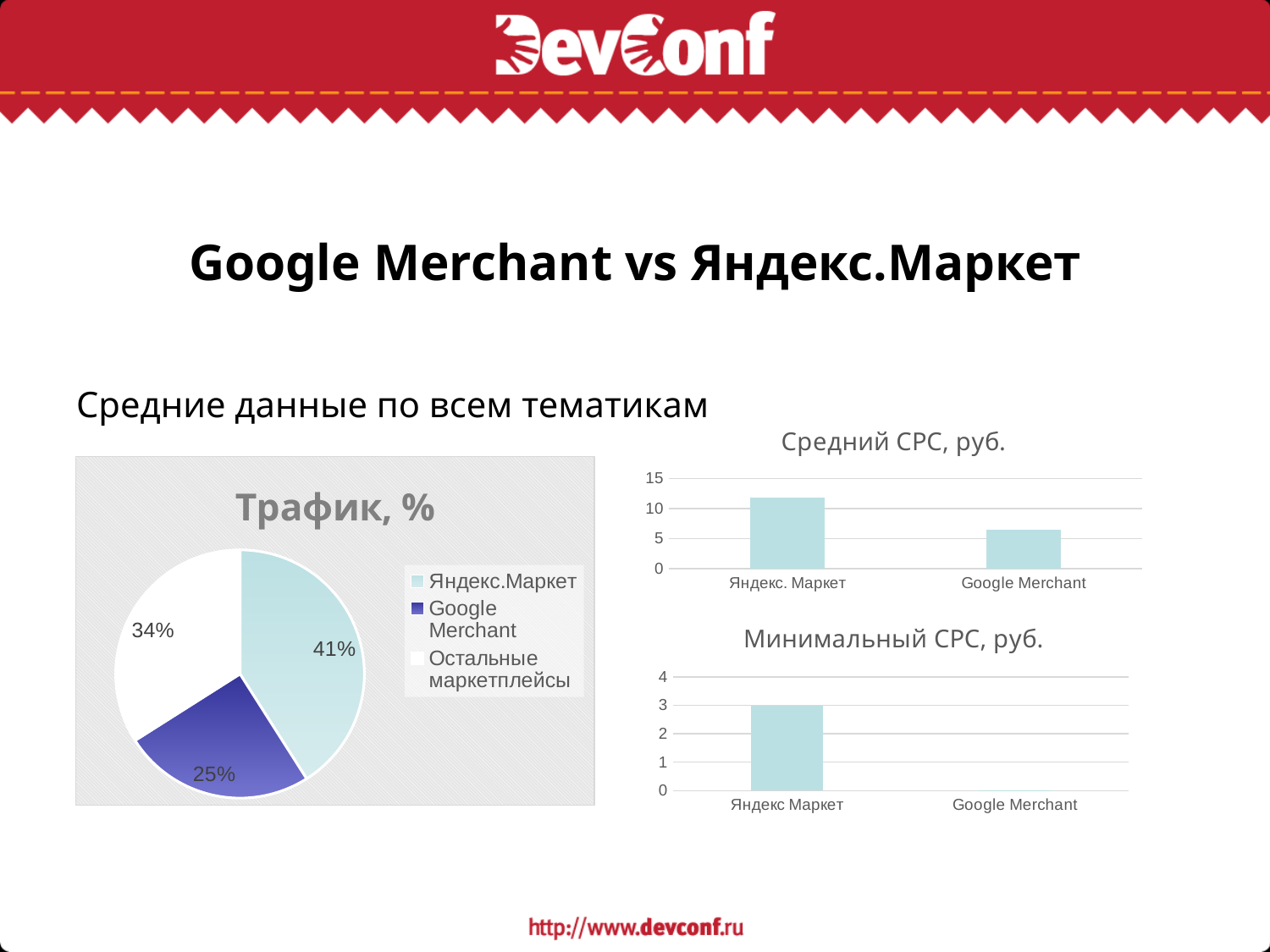
In the pie chart 'Трафик, %', what share do Остальные маркетплейсы have? 34% In the chart 'Средний CPC, руб.', is the value for Яндекс. Маркет greater or less than 10? greater In the chart 'Минимальный CPC, руб.', is the value for Google Merchant greater or less than 1? less In the chart 'Средний CPC, руб.', which category has the higher value, Яндекс. Маркет or Google Merchant? Яндекс. Маркет In the pie chart 'Трафик, %', what share does Яндекс.Маркет have? 41% What kind of chart is 'Средний CPC, руб.'? bar chart In the pie chart 'Трафик, %', what is the difference between the shares of Яндекс.Маркет and Google Merchant? 16% How many categories are shown in the chart 'Минимальный CPC, руб.'? 2 In the pie chart 'Трафик, %', what share does Google Merchant have? 25% In the pie chart 'Трафик, %', which category has the largest share? Яндекс.Маркет How many entries does the legend of the pie chart 'Трафик, %' list? 3 In the pie chart 'Трафик, %', which category has the smallest share? Google Merchant